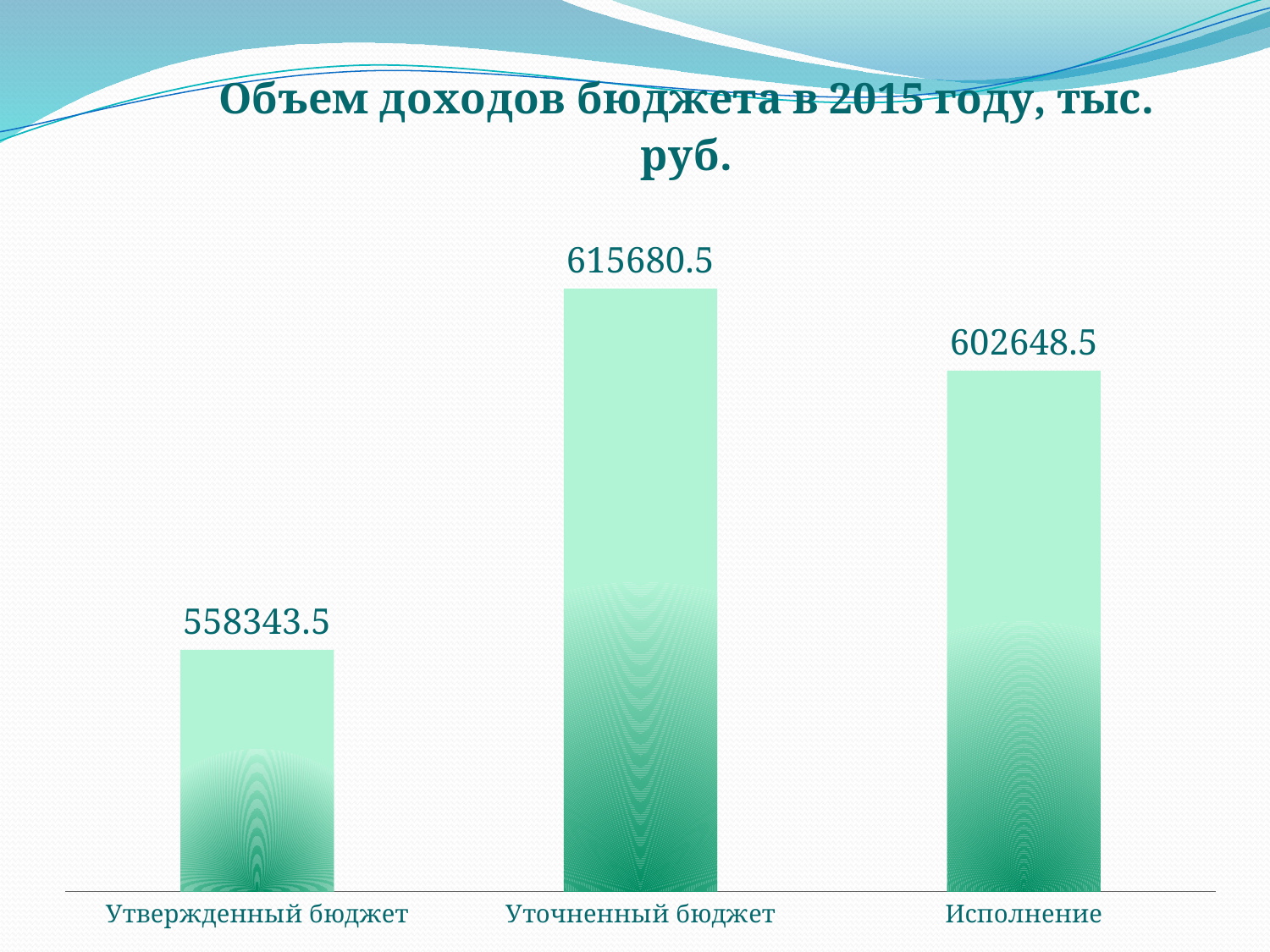
Which is larger, the value for Исполнение or the value for Утвержденный бюджет? Исполнение What kind of chart is shown on the slide? Bar chart What is the value for Утвержденный бюджет? 558343.5 How many categories are shown in the chart? 3 What is the value for Исполнение? 602648.5 What is the title of the chart? Объем доходов бюджета в 2015 году, тыс. руб. What is the difference between the values for Исполнение and Утвержденный бюджет? 44305 Which category has the highest value? Уточненный бюджет What is the difference between the values for Уточненный бюджет and Утвержденный бюджет? 57337 What is the difference between the values for Уточненный бюджет and Исполнение? 13032 Which category has the lowest value? Утвержденный бюджет What is the value for Уточненный бюджет? 615680.5